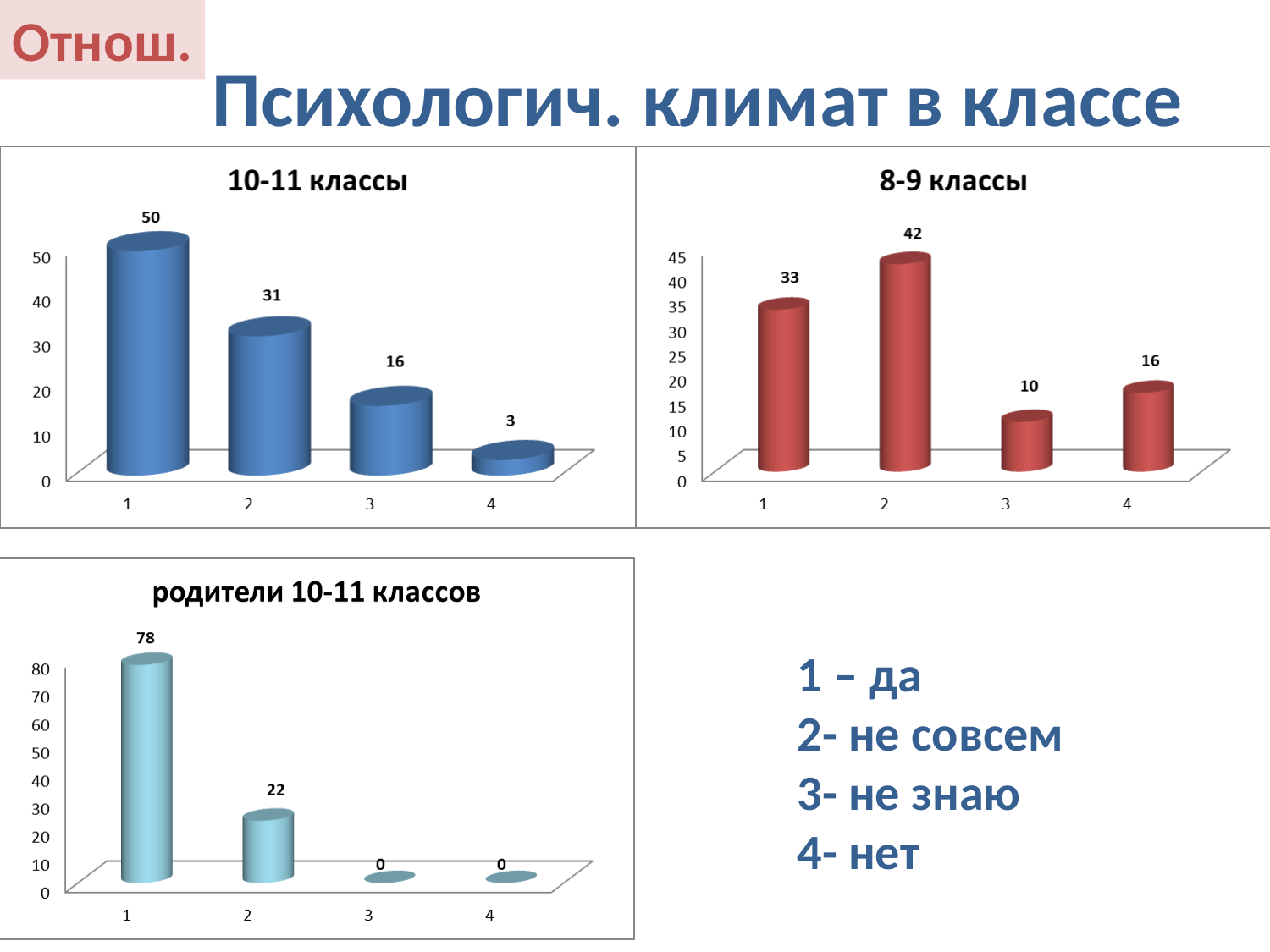
In the '10-11 классы' chart, which category has the lowest value? 4 In the '8-9 классы' chart, which category has the highest value? 2 In the '8-9 классы' chart, what is the difference between the values for category 2 and category 1? 9 Do the values in the '10-11 классы' chart rise or fall from category 1 to category 4? fall What kind of chart is the '8-9 классы' chart? bar chart In the '8-9 классы' chart, what is the value for category 3? 10 In the 'родители 10-11 классов' chart, what is the value for category 4? 0 In the '10-11 классы' chart, what is the difference between the values for category 1 and category 2? 19 In the 'родители 10-11 классов' chart, what is the value for category 2? 22 How many categories are shown in the 'родители 10-11 классов' chart? 4 In the '8-9 классы' chart, which is larger, the value for category 1 or category 4? category 1 In the '10-11 классы' chart, what is the value for category 1? 50